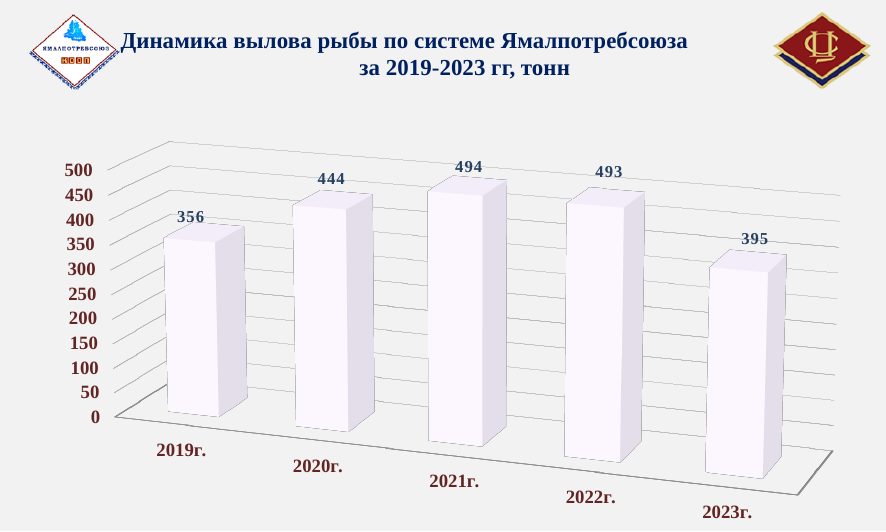
What is the difference between the values for 2020г. and 2019г.? 88 What is the title of the chart? Динамика вылова рыбы по системе Ямалпотребсоюза за 2019-2023 гг, тонн What is the value for 2023г.? 395 Which year has the highest value? 2021г. Which is larger, the value for 2020г. or the value for 2023г.? 2020г. Is the value for 2022г. greater or less than 450? greater What kind of chart is shown on the slide? bar chart What is the difference between the values for 2022г. and 2023г.? 98 What is the value for 2019г.? 356 How many years are shown on the chart? 5 What is the value for 2021г.? 494 Which year has the lowest value? 2019г.